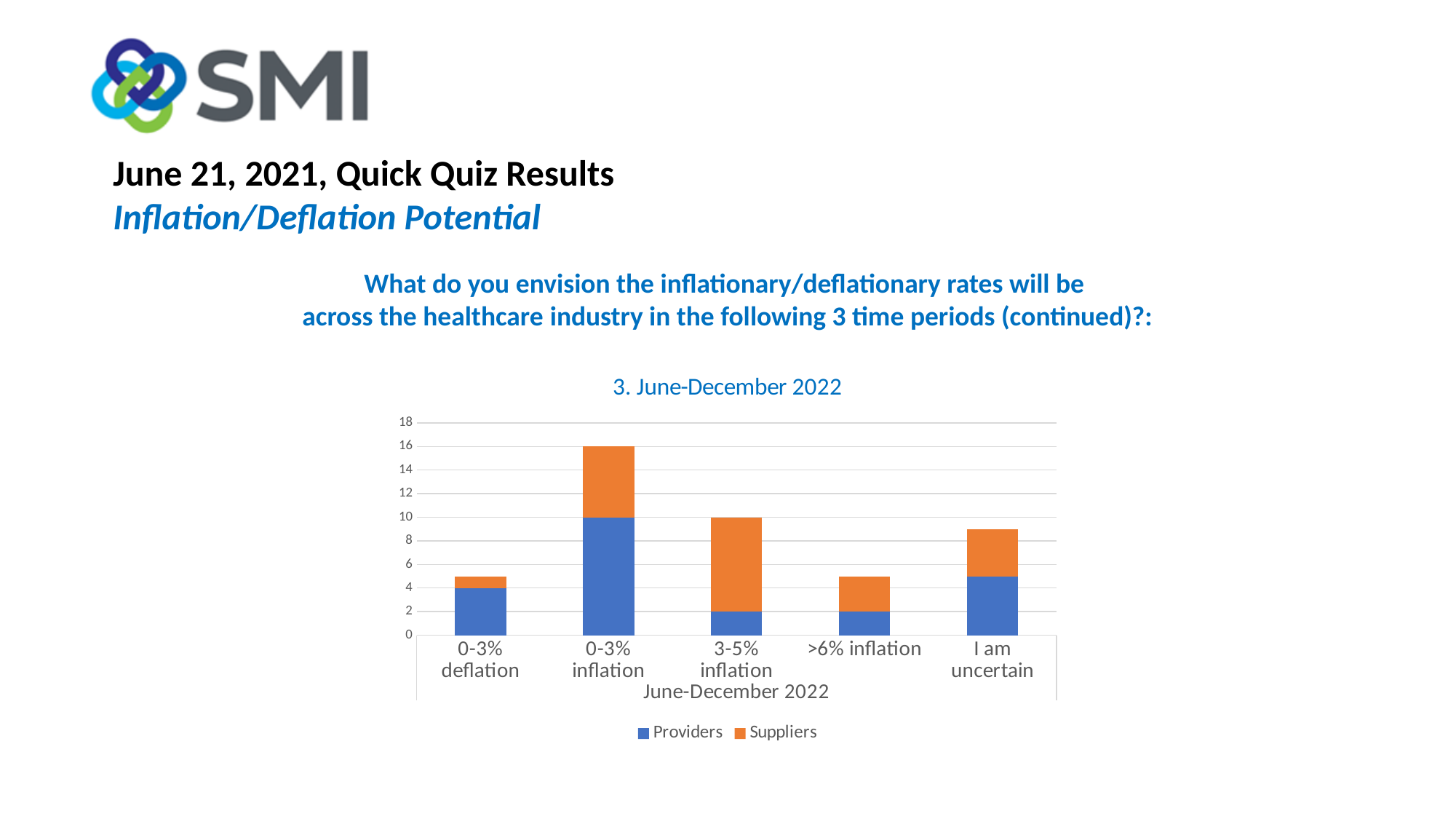
How many response categories are shown on the x axis? 5 What is the total height of the stacked bar for 3-5% inflation? 10 What is the Providers value for 3-5% inflation? 2 Is the total for >6% inflation greater or less than 6? less What type of chart is shown on the slide? Stacked bar chart What is the Providers value for 0-3% inflation? 10 Which category has the highest total stacked bar? 0-3% inflation How many series does the chart legend list? 2 What is the Providers value for 0-3% deflation? 4 Which two series are listed in the chart legend? Providers and Suppliers What is the total height of the stacked bar for 0-3% inflation? 16 What is the title of the chart? 3. June-December 2022